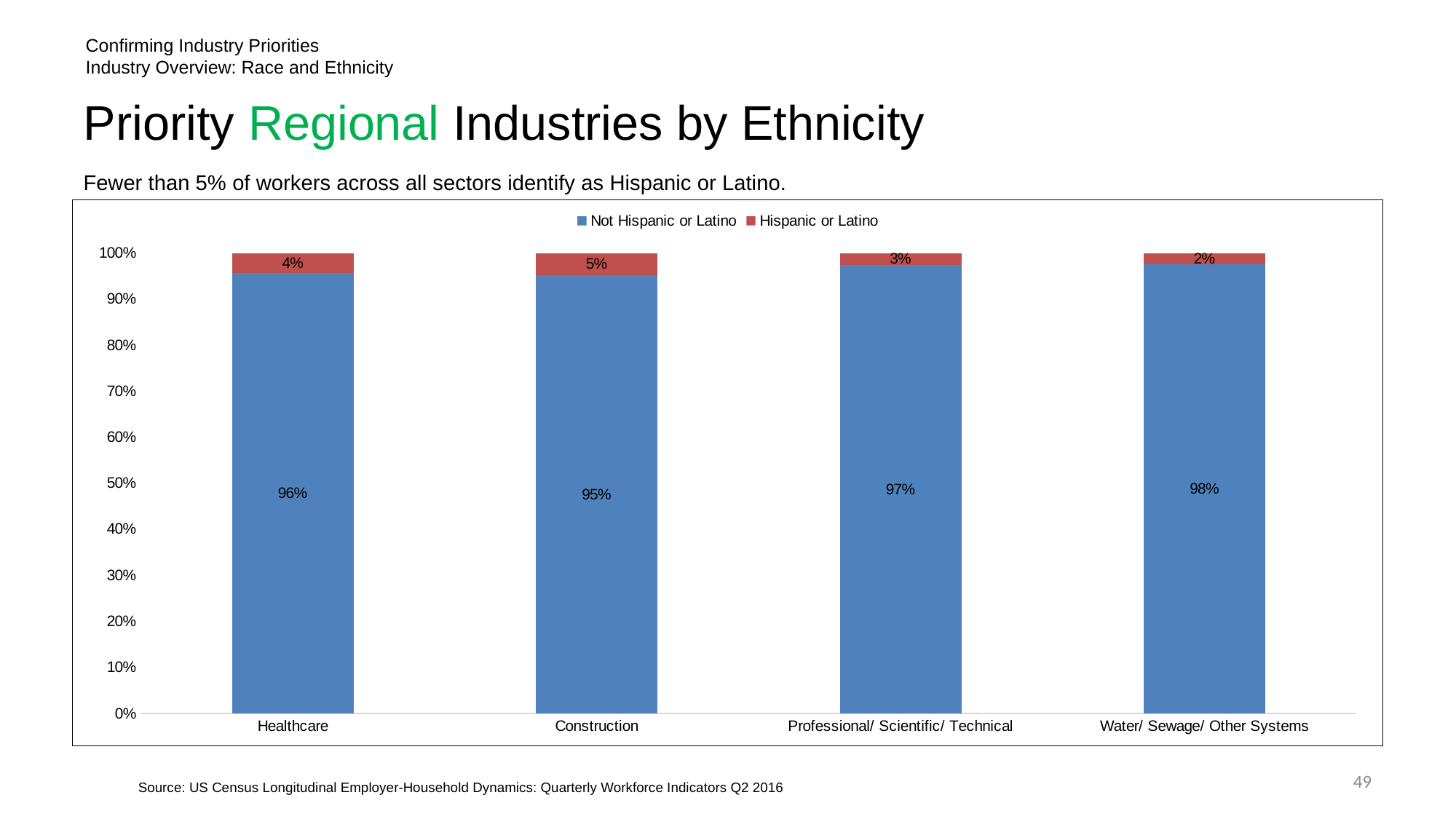
Which is larger: the Not Hispanic or Latino share in Healthcare or in Professional/ Scientific/ Technical? Professional/ Scientific/ Technical What percentage of Professional/ Scientific/ Technical workers are Not Hispanic or Latino? 97% Which industry has the lowest share of Hispanic or Latino workers? Water/ Sewage/ Other Systems What percentage of Water/ Sewage/ Other Systems workers are Hispanic or Latino? 2% What percentage of Healthcare workers are Not Hispanic or Latino? 96% What kind of chart is shown on the slide? Stacked bar chart What percentage of Construction workers are Hispanic or Latino? 5% How many series does the legend list? 2 How many industries are shown on the x axis? 4 What colour represents the Hispanic or Latino series? Red Which industry has the highest share of Hispanic or Latino workers? Construction What is the difference between the Hispanic or Latino share in Construction and in Water/ Sewage/ Other Systems? 3%